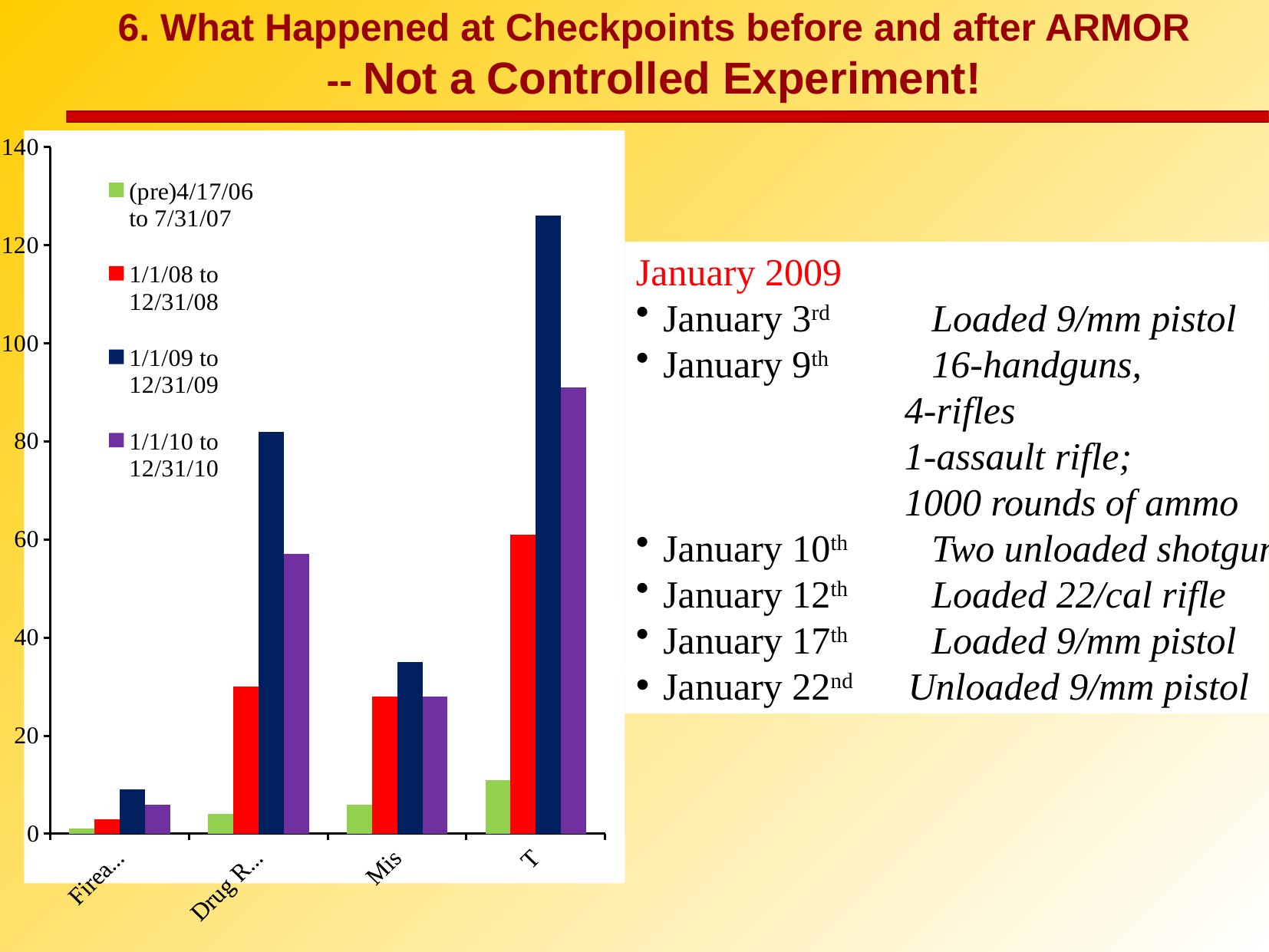
For the 1/1/09 to 12/31/09 series, which is larger: the value in the second category (Drug R...) or the value in category Mis? Drug R... What kind of chart is shown on the slide? bar chart How many series does the chart's legend list? 4 What colour are the bars for the 1/1/09 to 12/31/09 series? dark blue Which category has the tallest bar for the 1/1/09 to 12/31/09 series? T Is the value for the 1/1/10 to 12/31/10 series in category T greater or less than 80? greater How many categories are shown along the x axis of the chart? 4 Is the value for the 1/1/09 to 12/31/09 series in category Mis greater or less than 40? less Do the values of the (pre)4/17/06 to 7/31/07 series rise or fall from left to right across the categories? rise Is the value for the 1/1/08 to 12/31/08 series in category T greater or less than 40? greater In the category labelled T, which series has the highest value? 1/1/09 to 12/31/09